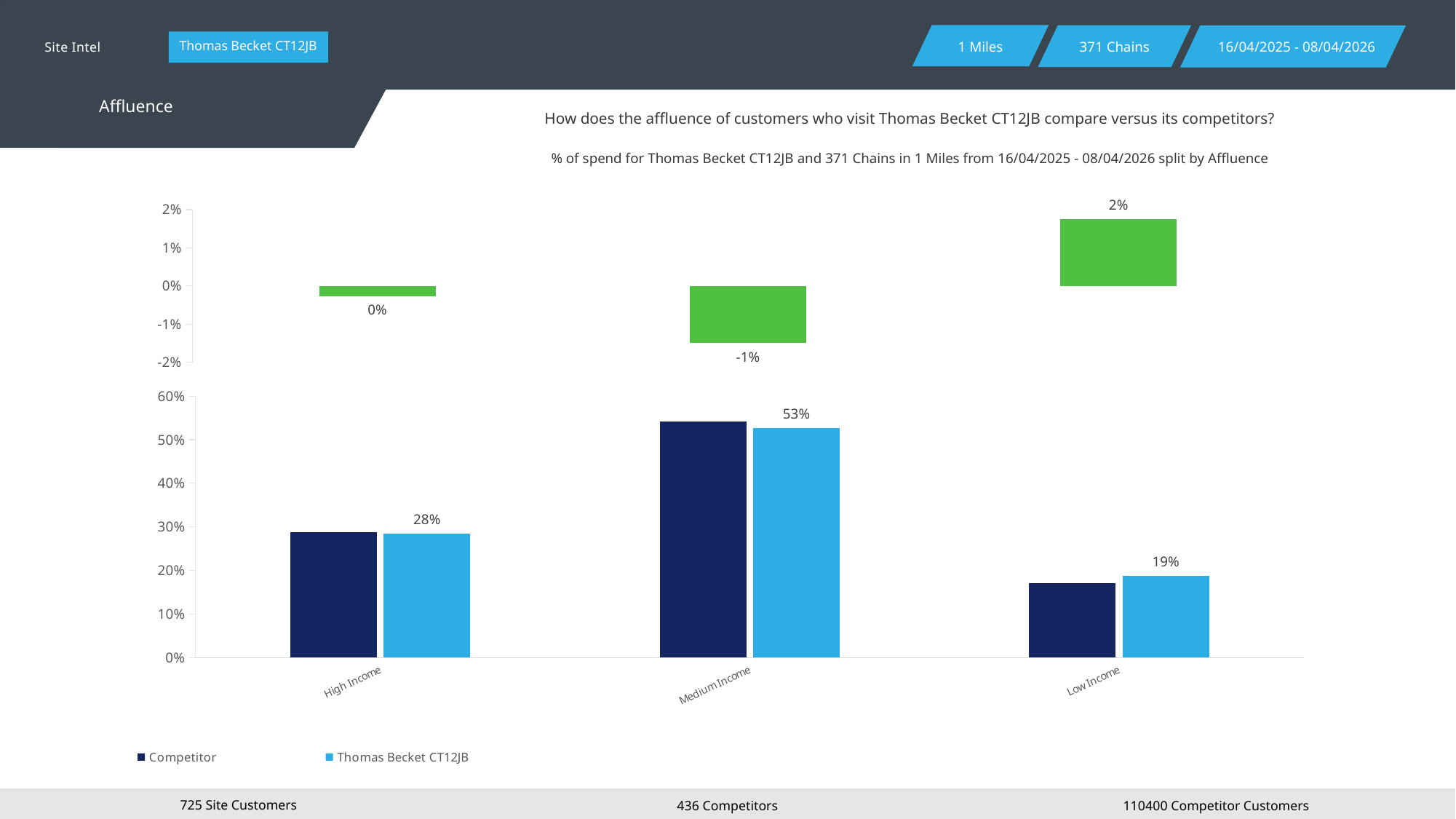
In the bottom chart, what is the value for Thomas Becket CT12JB in the Low Income category? 19% In the bottom chart, which category has the lowest value for Thomas Becket CT12JB? Low Income In the bottom chart, which category has the highest value for Thomas Becket CT12JB? Medium Income In the top chart, what is the value for Medium Income? -1% How many series does the legend of the bottom chart list? 2 In the bottom chart, is the Competitor value for Low Income greater or less than 20%? less In the bottom chart, what is the difference between the Thomas Becket CT12JB values for Medium Income and High Income? 25% What kind of chart is the bottom chart? Bar chart In the bottom chart, what is the value for Thomas Becket CT12JB in the Medium Income category? 53% In the bottom chart, is the Competitor value for Medium Income greater or less than 50%? greater In the bottom chart, what is the value for Thomas Becket CT12JB in the High Income category? 28% In the top chart, what is the value for Low Income? 2%